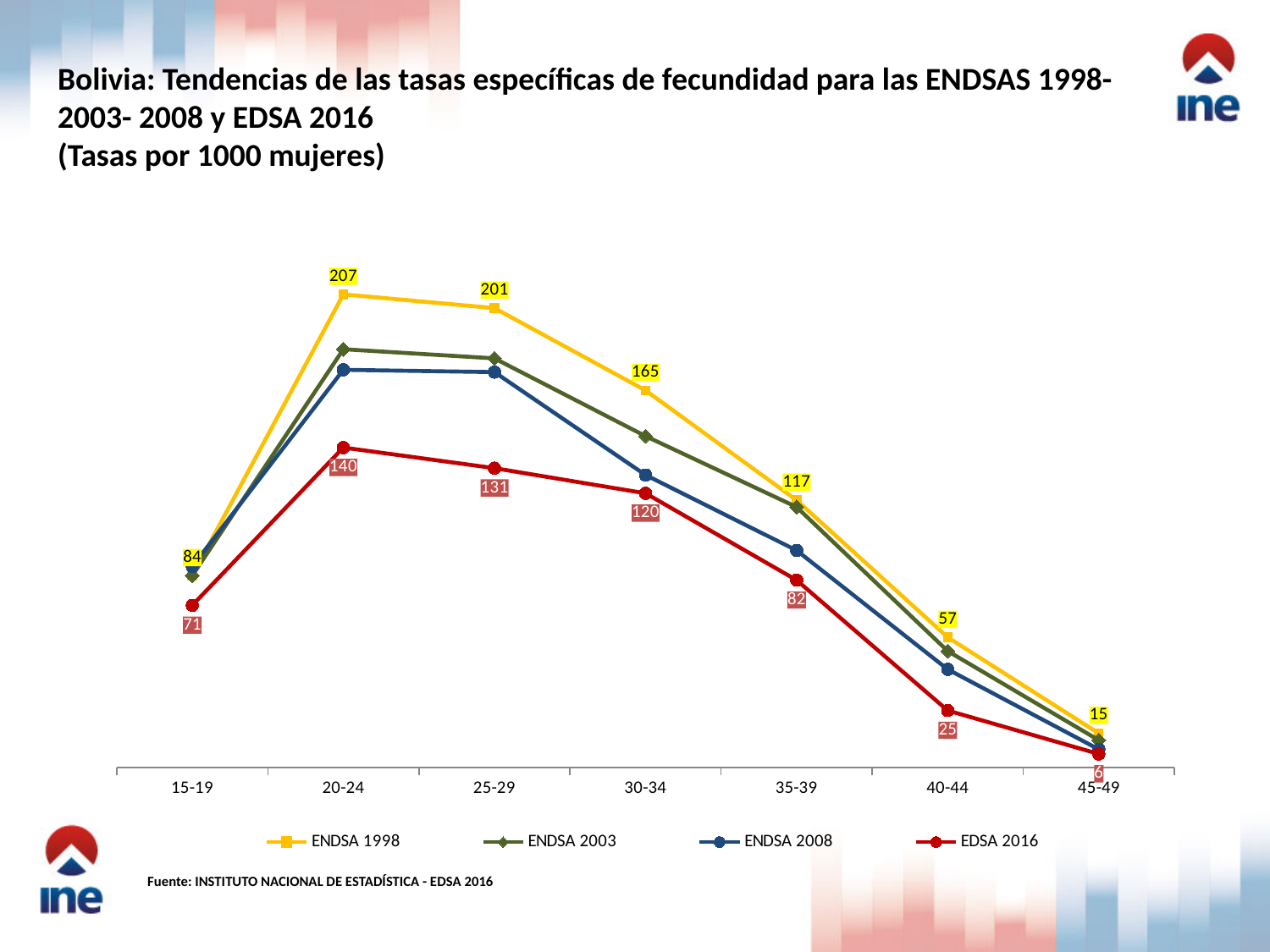
Do the EDSA 2016 values rise or fall from the 20-24 age group to the 45-49 age group? fall What is the difference between the EDSA 2016 values for 25-29 and 30-34? 11 What kind of chart is shown on the slide? line chart In the 35-39 age group, which is larger: ENDSA 1998 or EDSA 2016? ENDSA 1998 Which age group has the lowest value for ENDSA 1998? 45-49 What is the value for EDSA 2016 in the 30-34 age group? 120 What is the difference between ENDSA 1998 and EDSA 2016 in the 20-24 age group? 67 What is the value for ENDSA 1998 in the 40-44 age group? 57 Which age group has the highest value for EDSA 2016? 20-24 How many age groups are shown on the x axis? 7 How many series does the legend list? 4 What is the value for ENDSA 1998 in the 20-24 age group? 207